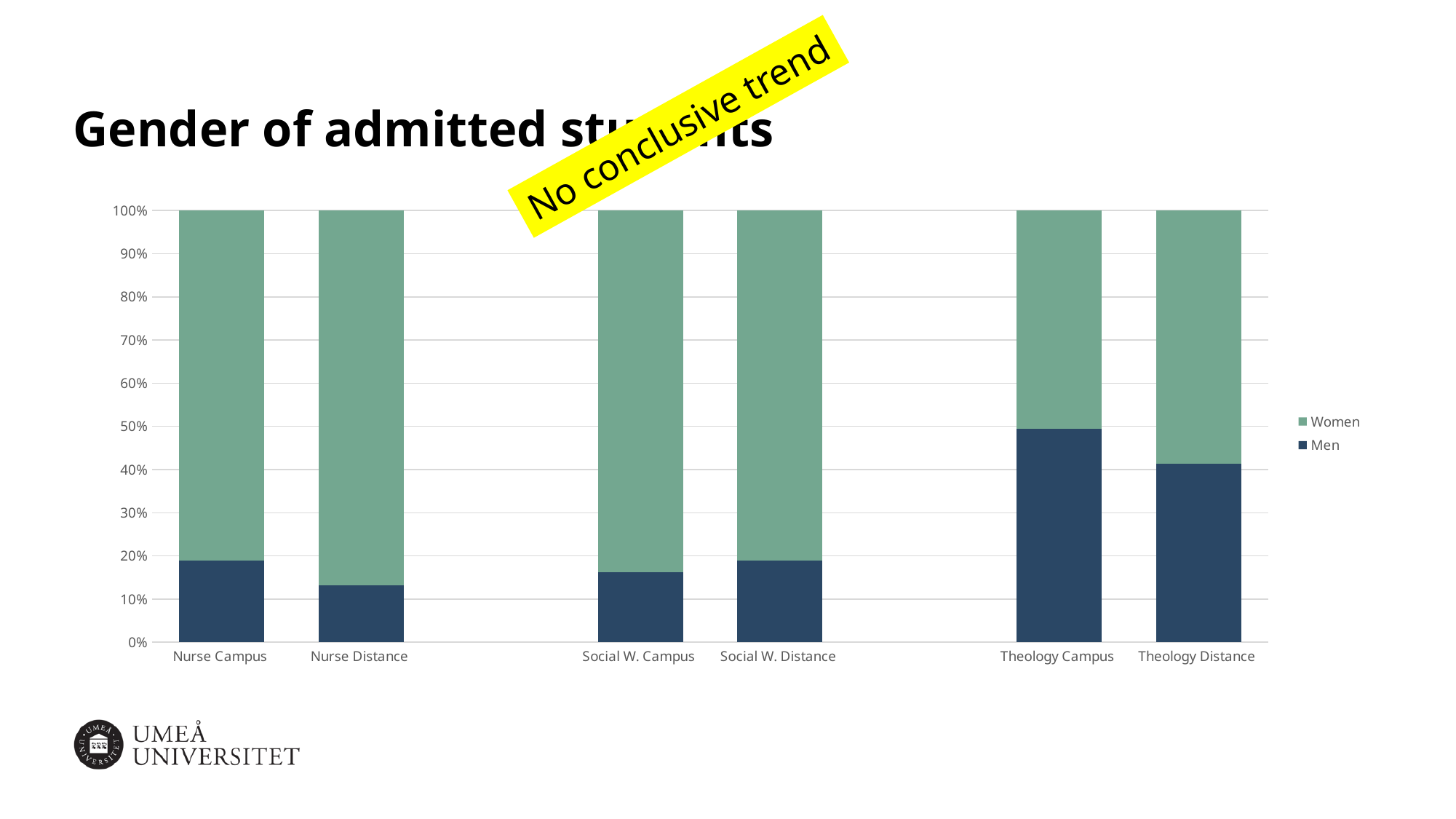
Is the share of Men for Theology Distance greater or less than 50%? less Is the share of Men for Nurse Distance greater or less than 20%? less How many series does the chart's legend list? 2 Which has a larger share of Men, Theology Campus or Theology Distance? Theology Campus What kind of chart is shown on the slide? Stacked bar chart Which category has the lowest share of Men? Nurse Distance Which has a larger share of Men, Nurse Campus or Nurse Distance? Nurse Campus Is the share of Men for Social W. Campus greater or less than 20%? less Which category has the highest share of Men? Theology Campus How many categories are shown along the x axis of the chart? 6 What is the total height of each stacked bar in the chart? 100%